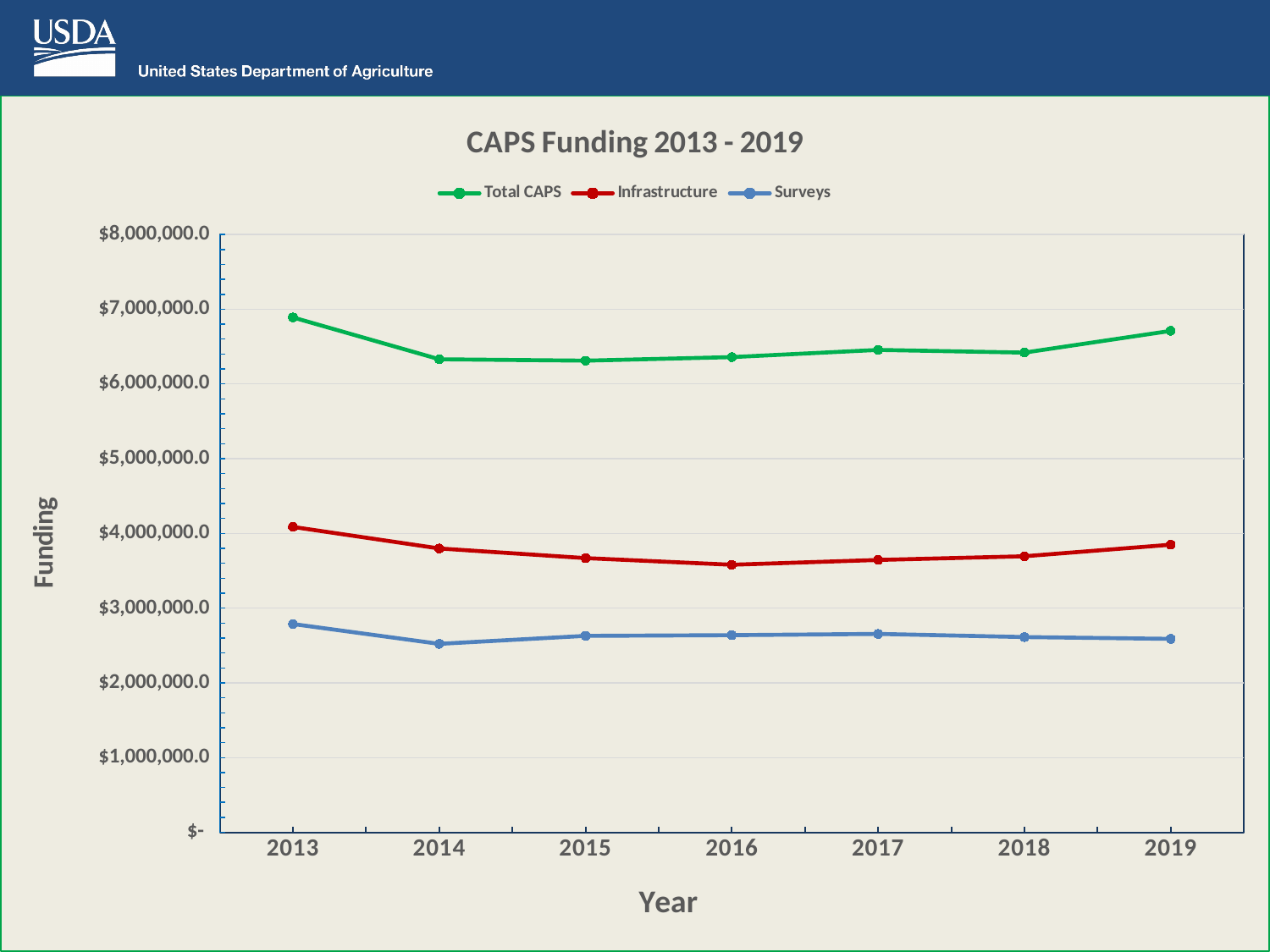
In which year is Total CAPS funding highest? 2013 Is the Total CAPS value for 2013 greater or less than $6,000,000.0? greater Which series is drawn in red? Infrastructure In which year is Infrastructure funding highest? 2013 In which year is Surveys funding highest? 2013 How many years are plotted along the x axis? 7 Does Total CAPS funding rise or fall from 2013 to 2014? fall Is the Infrastructure value for 2016 greater or less than $4,000,000.0? less What is the title of the chart? CAPS Funding 2013 - 2019 Which is larger in 2015, Infrastructure funding or Surveys funding? Infrastructure What kind of chart is shown on the slide? line chart How many series does the legend list? 3